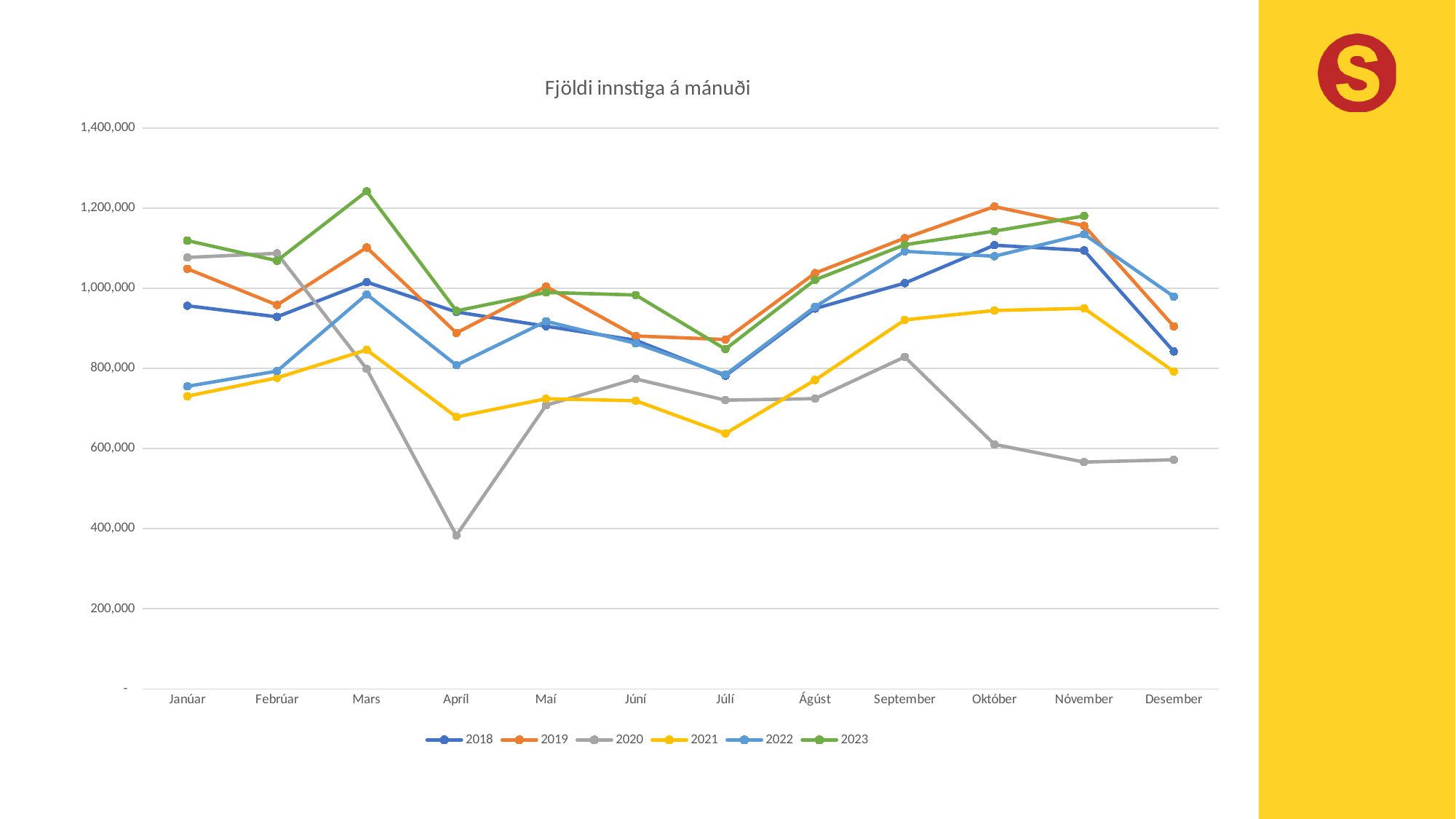
How many months are shown on the x axis? 12 Which series has the lowest value in Apríl? 2020 In which month does the 2019 series reach its highest value? Október What is the title of the chart? Fjöldi innstiga á mánuði In which month does the 2020 series reach its lowest value? Apríl How many series does the legend list? 6 Is the value for 2020 in Apríl greater or less than 400,000? less What kind of chart is shown on the slide? line chart Which series has the highest value in Mars? 2023 Is the value for 2021 in Júlí greater or less than 700,000? less Does the 2020 series rise or fall from September to Nóvember? fall Is the value for 2023 in Mars greater or less than 1,200,000? greater